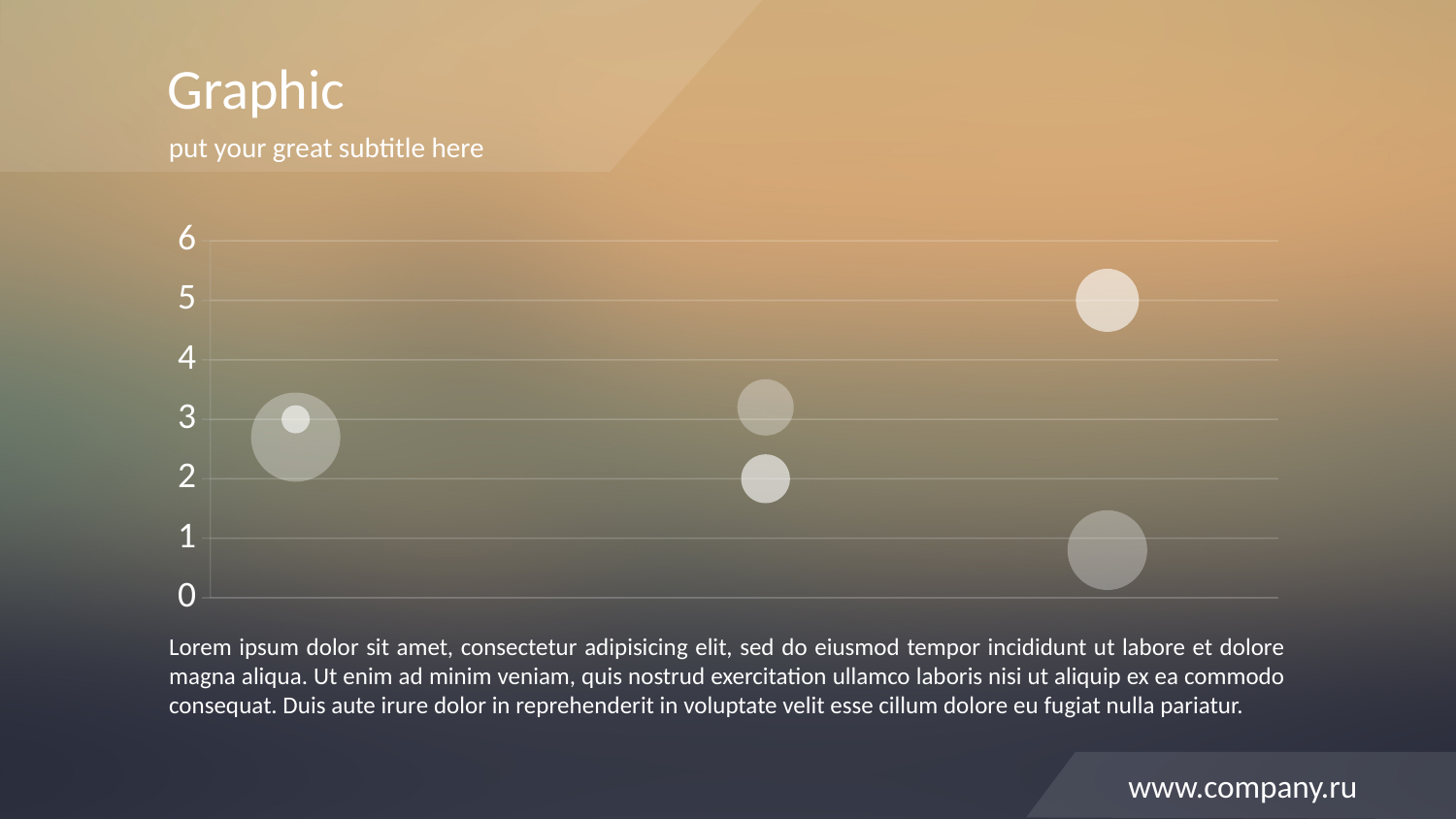
Is the value of the topmost bubble on the chart greater or less than 4? greater Is the value of the lowest bubble on the chart greater or less than 1? less What is the highest value shown on the chart's vertical axis? 6 How many bubbles are plotted on the chart? 6 What is the title of the slide containing the chart? Graphic Is the value of the topmost bubble on the chart greater or less than 6? less What kind of chart is shown on the slide? bubble chart